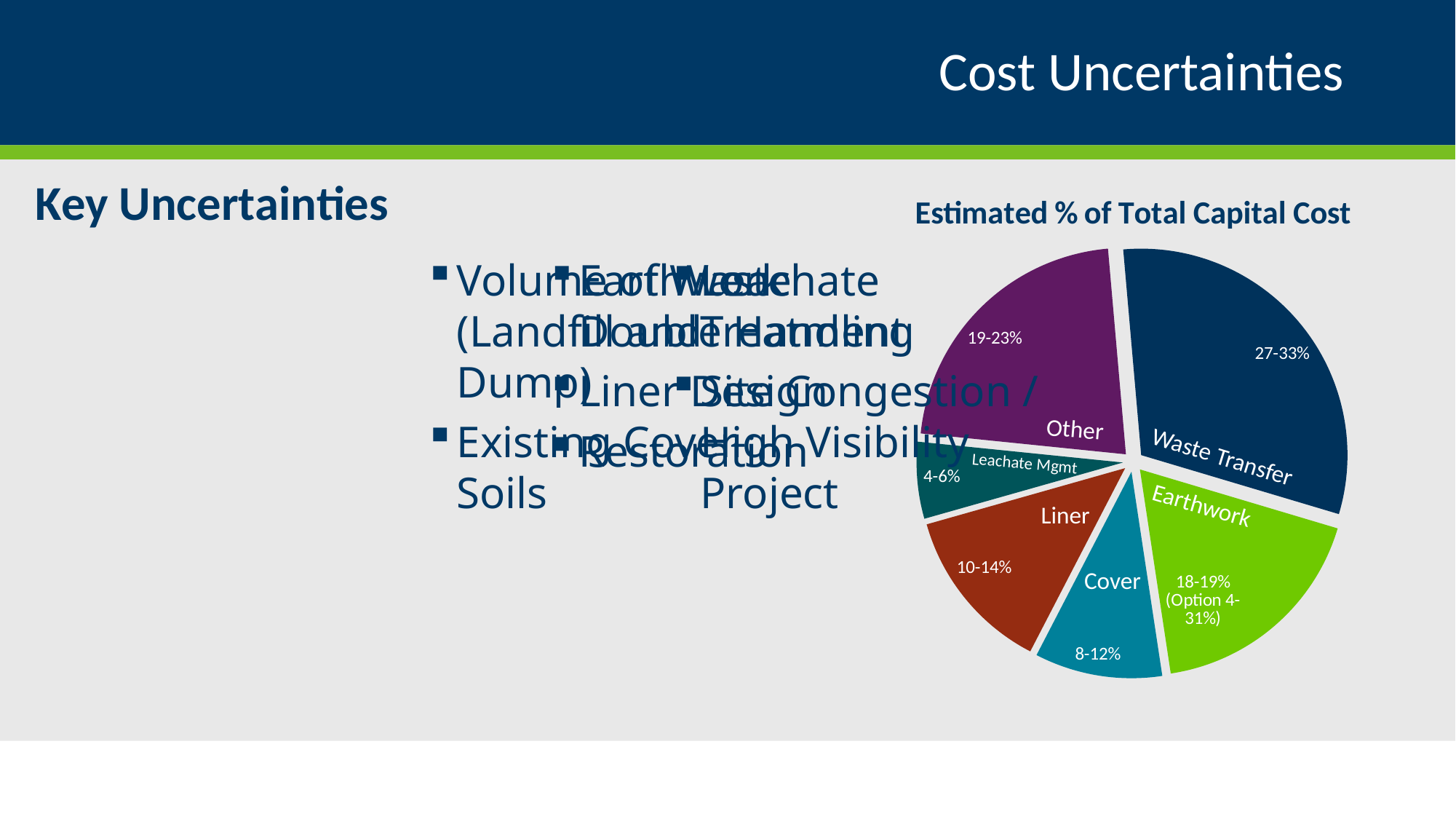
Which slice represents the largest share of total capital cost? Waste Transfer What estimated percentage of total capital cost is shown for Liner? 10-14% What estimated percentage of total capital cost is shown for Cover? 8-12% Which slice represents the smallest share of total capital cost? Leachate Mgmt What label is printed on the Earthwork slice? 18-19% (Option 4-31%) What estimated percentage of total capital cost is shown for Leachate Mgmt? 4-6% How many slices does the pie chart have? 6 What kind of chart is shown on the slide? pie chart What estimated percentage of total capital cost is shown for Waste Transfer? 27-33% What is the title of the chart? Estimated % of Total Capital Cost What estimated percentage of total capital cost is shown for Other? 19-23% Which slice is larger, Waste Transfer or Other? Waste Transfer